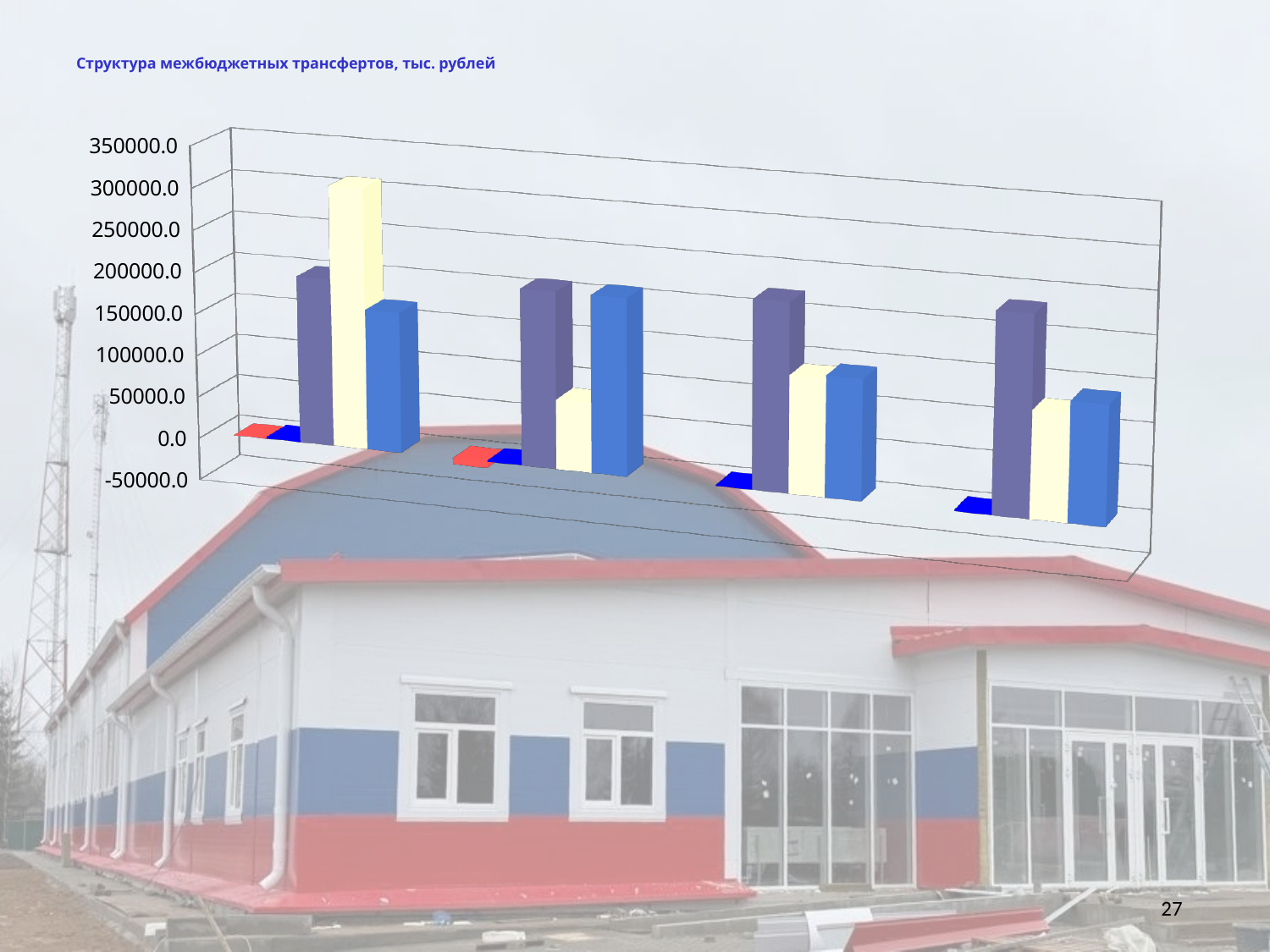
In the first group from the left, which is taller: the cream-coloured bar or the light blue bar? the cream-coloured bar In the second group from the left, is the cream-coloured bar greater or less than 100000.0? less What is the title of the chart? Структура межбюджетных трансфертов, тыс. рублей In the first group from the left, is the cream-coloured bar greater or less than 250000.0? greater What kind of chart is shown on the slide? bar chart How many groups of bars are plotted along the x axis? 4 In the second group from the left, which is taller: the cream-coloured bar or the light blue bar? the light blue bar Which group of bars contains the tallest bar on the chart? the first group from the left What is the highest value labelled on the vertical axis? 350000.0 In the first group from the left, is the purple bar greater or less than 150000.0? greater